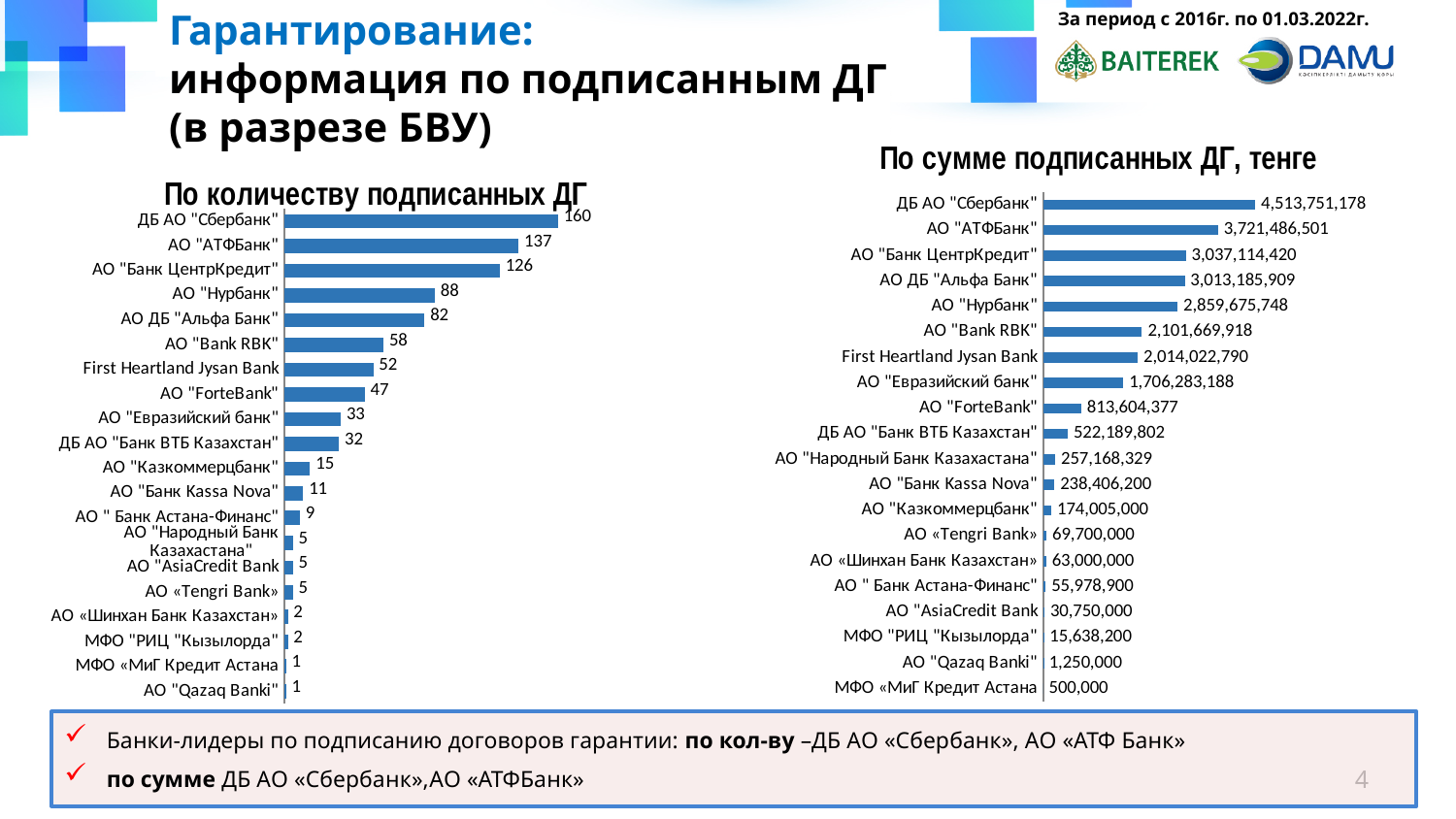
In the chart "По количеству подписанных ДГ", what is the difference between ДБ АО "Сбербанк" and АО "АТФБанк"? 23 In the chart "По количеству подписанных ДГ", what is the value for АО "Qazaq Banki"? 1 In the chart "По сумме подписанных ДГ, тенге", which bank has the lowest value? МФО «МиГ Кредит Астана In the chart "По количеству подписанных ДГ", how many banks are listed? 20 In the chart "По сумме подписанных ДГ, тенге", what is the value for АО "ForteBank"? 813,604,377 In the chart "По количеству подписанных ДГ", which is larger: АО "Bank RBK" or First Heartland Jysan Bank? АО "Bank RBK" In the chart "По сумме подписанных ДГ, тенге", what is the value for АО "Bank RBK"? 2,101,669,918 In the chart "По сумме подписанных ДГ, тенге", which is larger: АО "Банк ЦентрКредит" or АО ДБ "Альфа Банк"? АО "Банк ЦентрКредит" In the chart "По сумме подписанных ДГ, тенге", what is the difference between АО "Tengri Bank" and АО «Шинхан Банк Казахстан»? 6,700,000 In the chart "По количеству подписанных ДГ", what is the value for АО "Нурбанк"? 88 What type of chart is "По сумме подписанных ДГ, тенге"? Bar chart In the chart "По количеству подписанных ДГ", which bank has the highest value? ДБ АО "Сбербанк"